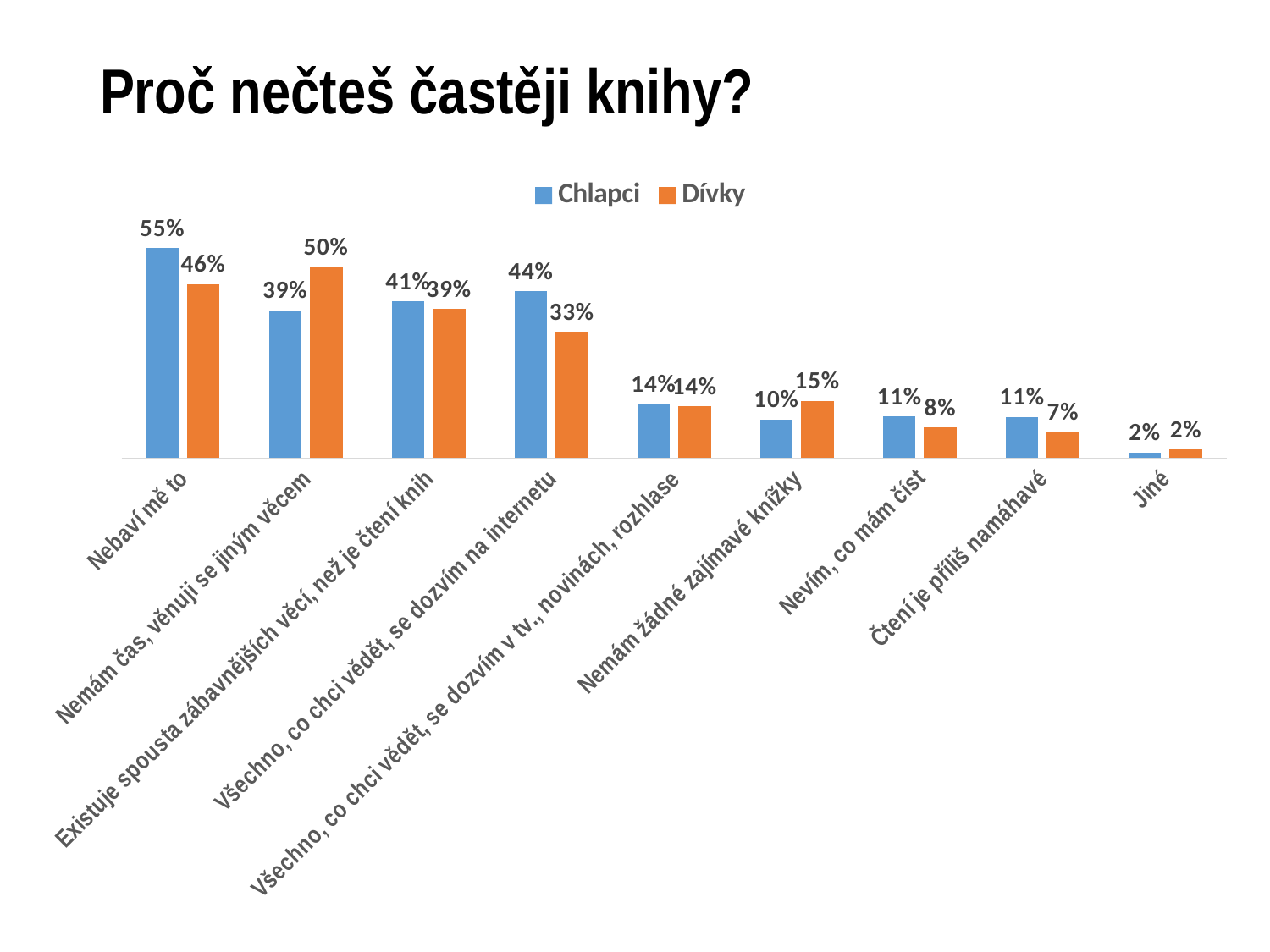
Which category has the lowest Dívky value? Jiné What is the Chlapci value for "Nebaví mě to"? 55% What kind of chart is shown on the slide? Bar chart What is the Dívky value for "Nemám čas, věnuji se jiným věcem"? 50% How many series does the legend list? 2 How many categories are shown on the x axis? 9 Which is larger for "Nemám žádné zajímavé knížky": the Chlapci value or the Dívky value? Dívky What is the title of the slide? Proč nečteš častěji knihy? Which category has the highest Chlapci value? Nebaví mě to What is the difference between the Chlapci and Dívky values for "Všechno, co chci vědět, se dozvím na internetu"? 11% Which colour represents the Dívky series? Orange What is the Dívky value for "Všechno, co chci vědět, se dozvím na internetu"? 33%